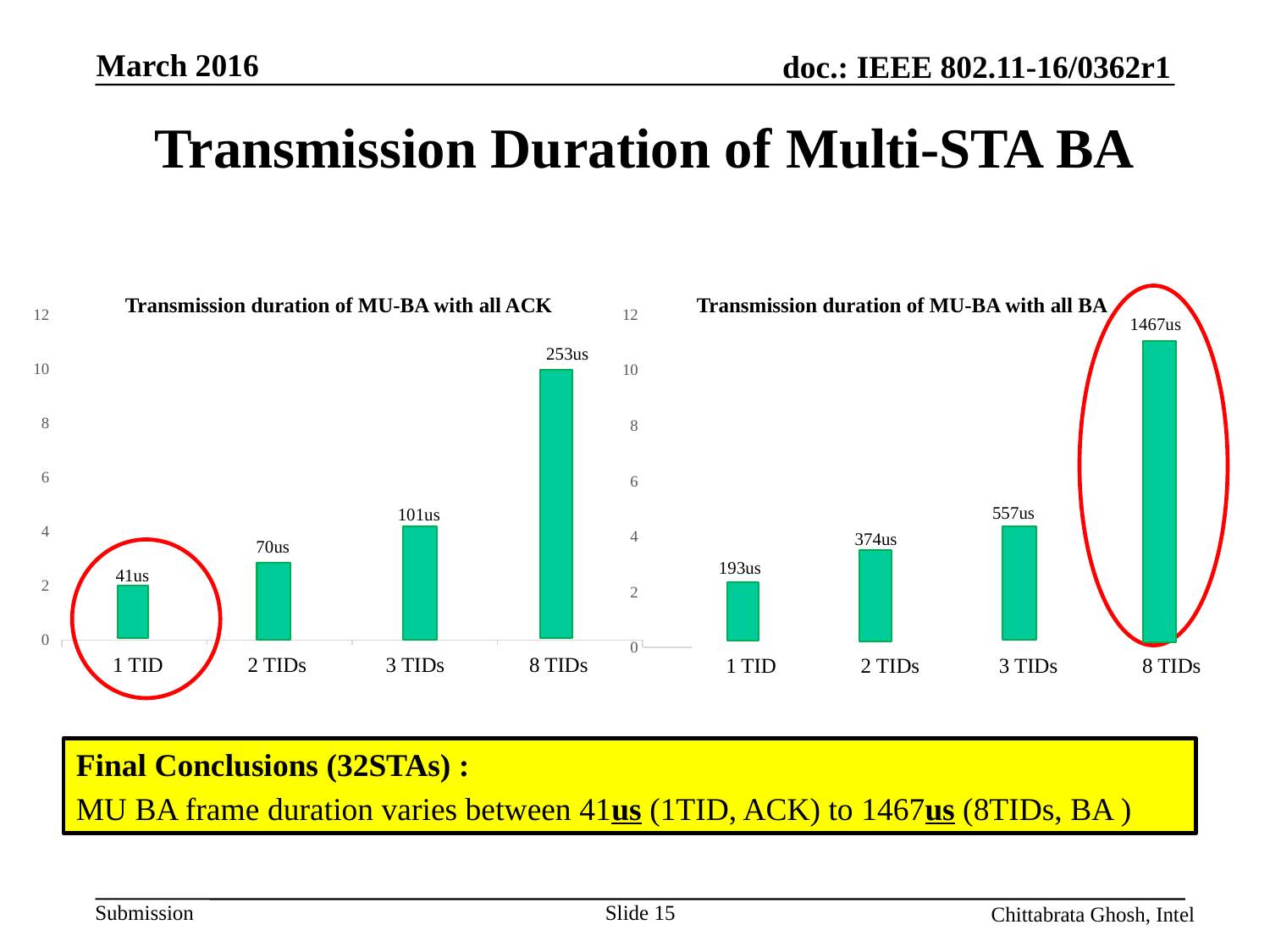
In the 'Transmission duration of MU-BA with all BA' chart, what is the value for 8 TIDs? 1467us In the 'Transmission duration of MU-BA with all ACK' chart, what is the difference between the values for 8 TIDs and 1 TID? 212us In the 'Transmission duration of MU-BA with all BA' chart, what is the value for 2 TIDs? 374us In the 'Transmission duration of MU-BA with all ACK' chart, what is the value for 3 TIDs? 101us How many categories are shown on the x axis of the 'Transmission duration of MU-BA with all BA' chart? 4 What kind of chart is the 'Transmission duration of MU-BA with all ACK' chart? Bar chart In the 'Transmission duration of MU-BA with all ACK' chart, which category has the highest value? 8 TIDs In the 'Transmission duration of MU-BA with all BA' chart, what is the difference between the values for 3 TIDs and 1 TID? 364us In the 'Transmission duration of MU-BA with all BA' chart, which category has the lowest value? 1 TID Which is larger: the value for 2 TIDs in the 'all ACK' chart or the value for 2 TIDs in the 'all BA' chart? 2 TIDs in the 'all BA' chart In the 'Transmission duration of MU-BA with all ACK' chart, what is the value for 1 TID? 41us In the 'Transmission duration of MU-BA with all BA' chart, do the values rise or fall from 1 TID to 8 TIDs? Rise